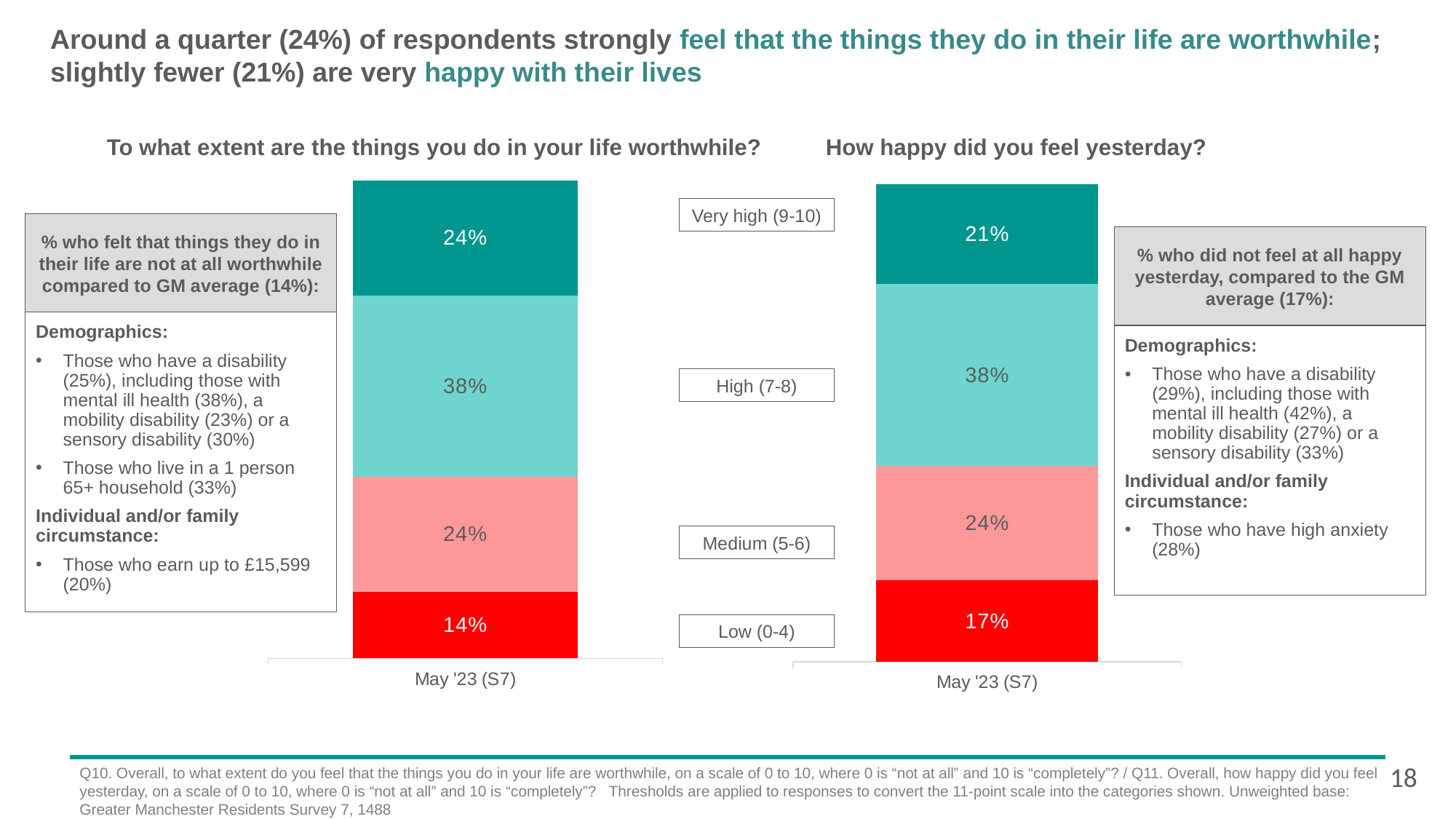
In the chart 'How happy did you feel yesterday?', what percentage of respondents are in the Low (0-4) category? 17% In the chart 'How happy did you feel yesterday?', what percentage of respondents are in the High (7-8) category? 38% In the chart 'To what extent are the things you do in your life worthwhile?', what is the difference between the High (7-8) and Very high (9-10) percentages? 14 percentage points How many categories are stacked in each bar on the slide? 4 In the chart 'To what extent are the things you do in your life worthwhile?', what percentage of respondents are in the Low (0-4) category? 14% In the chart 'To what extent are the things you do in your life worthwhile?', which category has the largest share of respondents? High (7-8) What type of chart is used on this slide to show the responses? Stacked bar chart In the chart 'To what extent are the things you do in your life worthwhile?', what percentage of respondents are in the Very high (9-10) category? 24% What is the x-axis label under each bar on the slide? May '23 (S7) Which chart has the larger Very high (9-10) percentage: 'To what extent are the things you do in your life worthwhile?' or 'How happy did you feel yesterday?' To what extent are the things you do in your life worthwhile? In the chart 'How happy did you feel yesterday?', which category has the smallest share of respondents? Low (0-4) In the chart 'How happy did you feel yesterday?', what is the combined percentage of the Very high (9-10) and High (7-8) categories? 59%